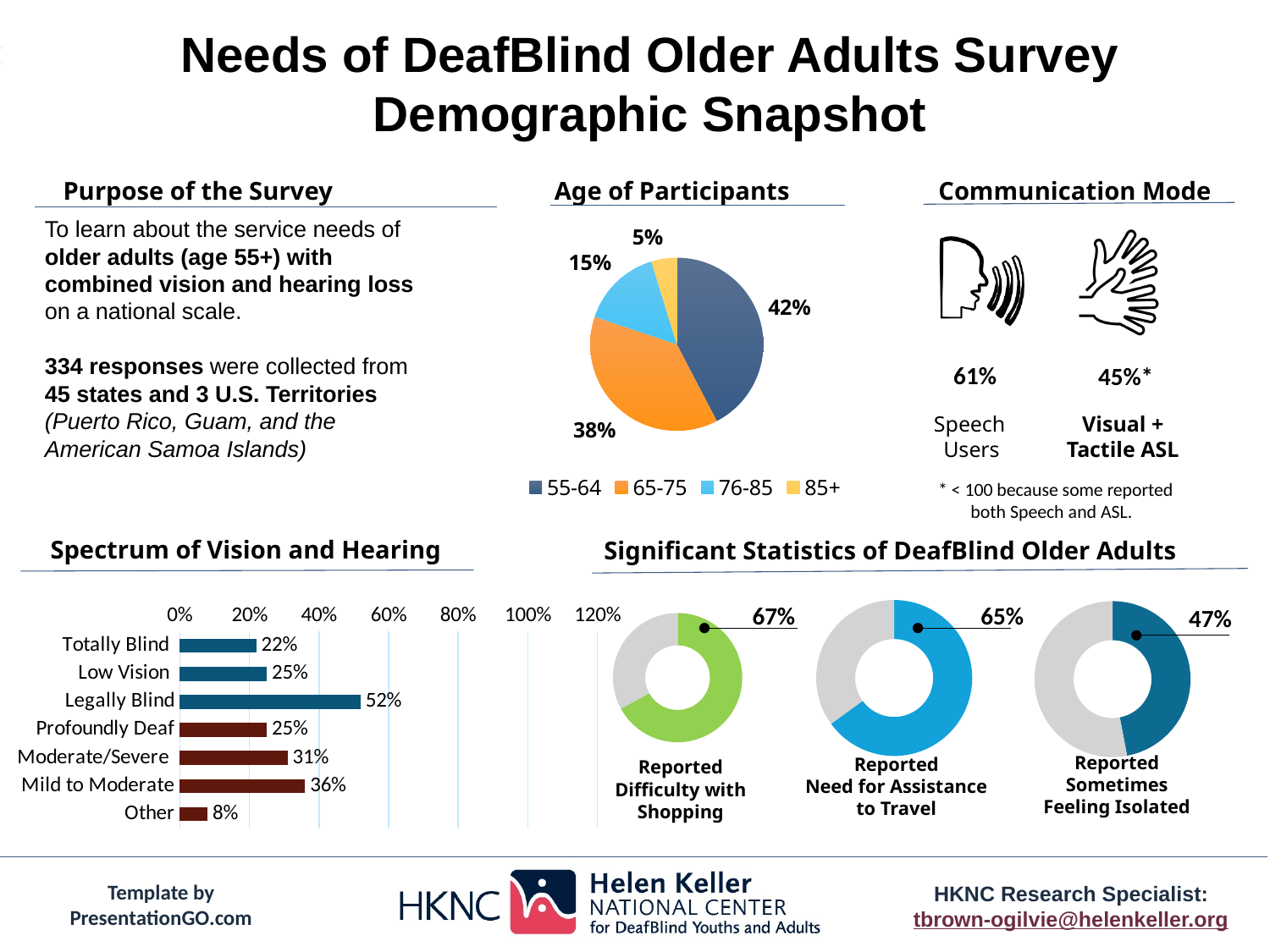
In the Spectrum of Vision and Hearing chart, which category has the lowest value? Other In the Age of Participants pie chart, what is the difference between the 65-75 share and the 76-85 share? 23% In the Significant Statistics of DeafBlind Older Adults section, what is the difference between the share reporting difficulty with shopping and the share reporting sometimes feeling isolated? 20% In the Significant Statistics of DeafBlind Older Adults section, what percentage reported need for assistance to travel? 65% In the Age of Participants pie chart, which age group has the smallest share? 85+ In the Spectrum of Vision and Hearing chart, which is larger, Mild to Moderate or Moderate/Severe? Mild to Moderate What kind of chart is the Spectrum of Vision and Hearing chart? Bar chart In the Age of Participants pie chart, what share of participants are aged 55-64? 42% In the Spectrum of Vision and Hearing chart, what is the value for Legally Blind? 52% In the Age of Participants pie chart, how many age groups does the legend list? 4 What kind of chart is the Age of Participants chart? Pie chart In the Spectrum of Vision and Hearing chart, how many categories are shown? 7